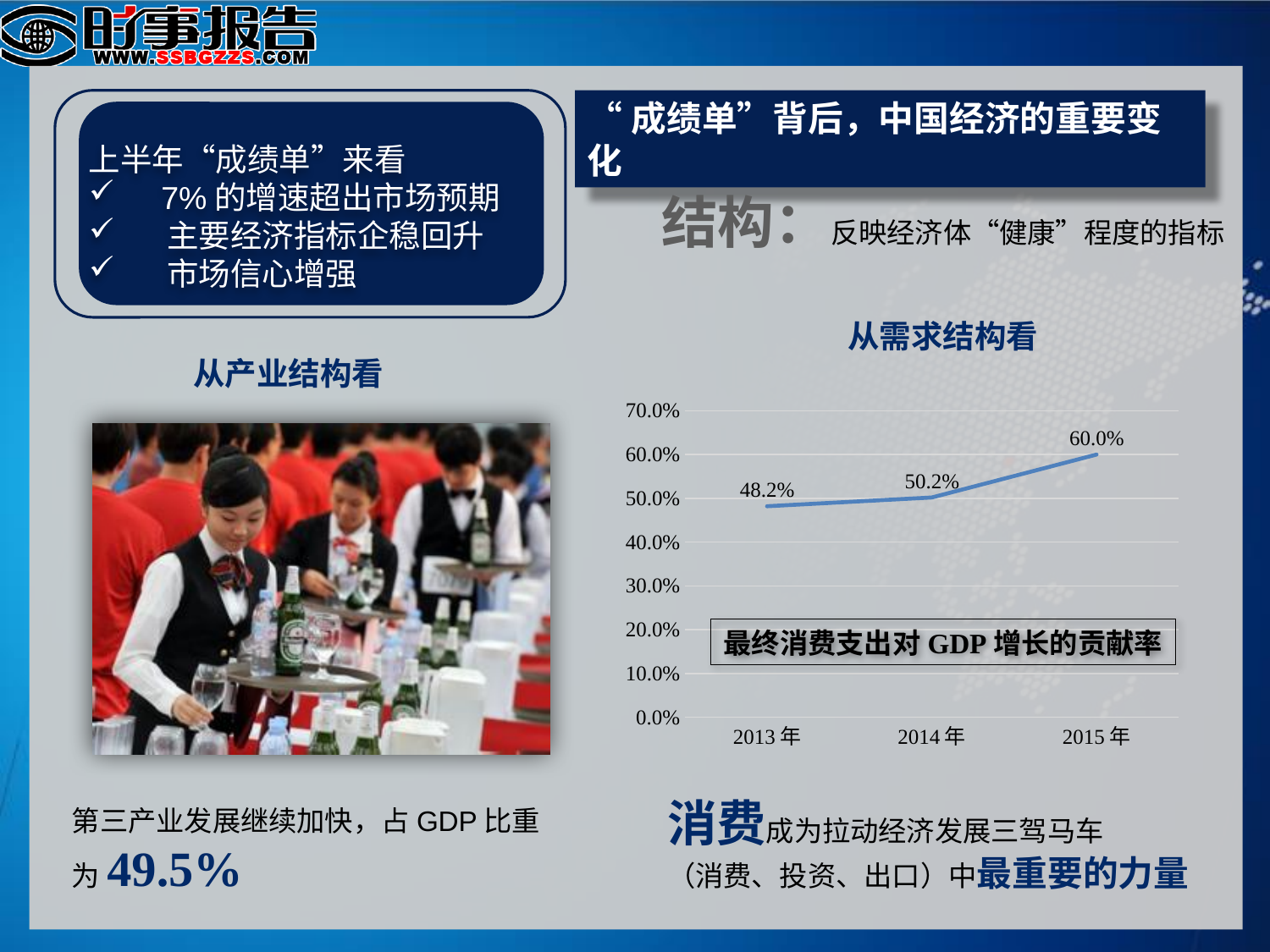
How many data points are plotted in the line chart? 3 What is the value for 2015年 in the line chart? 60.0% Is the value for 2015年 greater or less than 50.0%? greater What is the value for 2013年 in the line chart? 48.2% What is the difference between the 2015年 and 2014年 values in the line chart? 9.8% What kind of chart is shown on the slide? line chart Do the values in the line chart rise or fall from 2013年 to 2015年? rise What is the value for 2014年 in the line chart? 50.2% What is the difference between the 2014年 and 2013年 values in the line chart? 2.0% Which year has the lowest value in the line chart? 2013年 Which is larger in the line chart, the value for 2013年 or the value for 2015年? 2015年 Which year has the highest value in the line chart? 2015年